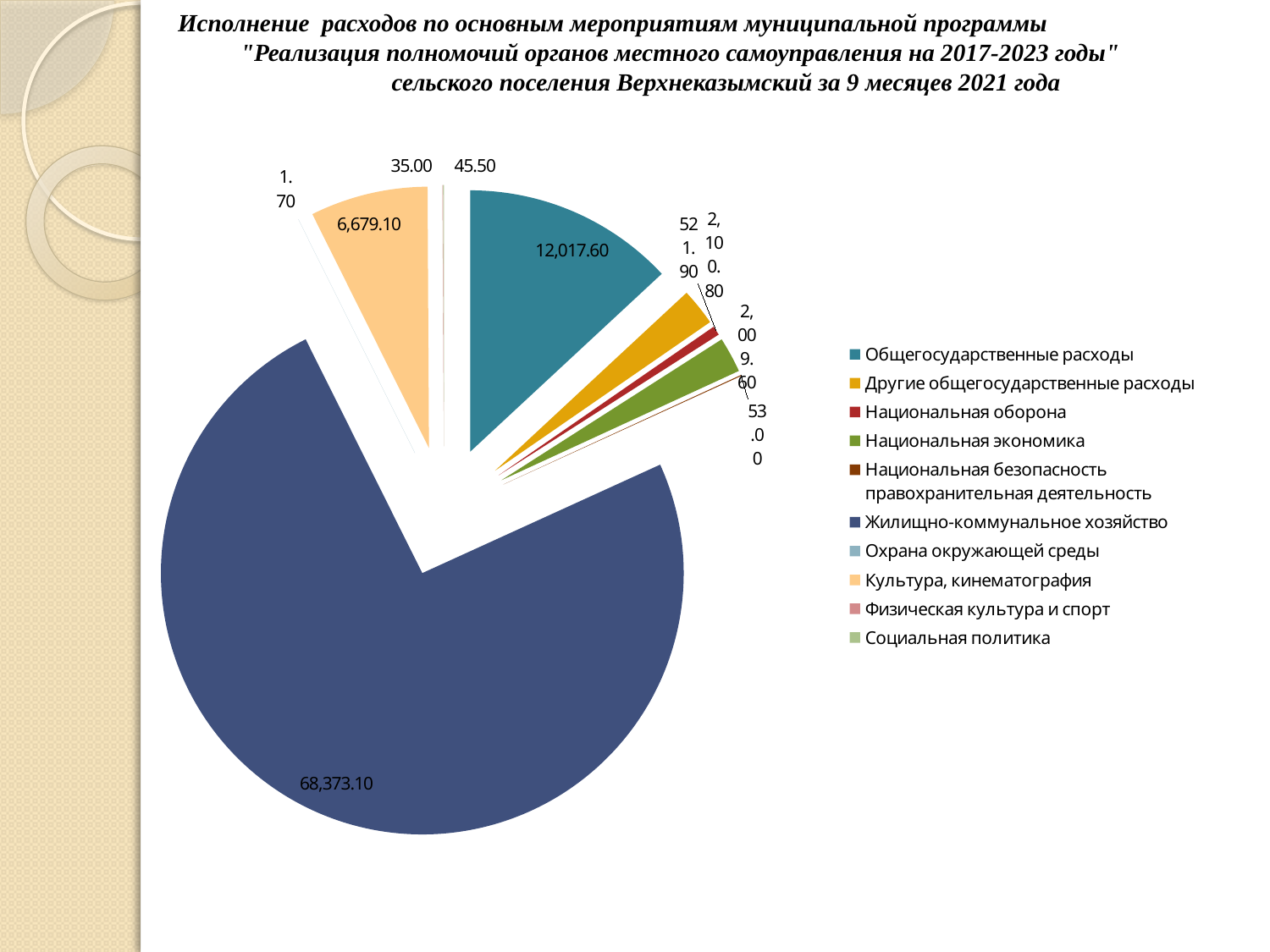
What colour is the slice for Жилищно-коммунальное хозяйство in the pie chart? dark blue Which category has the largest slice in the pie chart? Жилищно-коммунальное хозяйство What is the value shown for Общегосударственные расходы? 12,017.60 Which is larger, the value for Общегосударственные расходы or the value for Культура, кинематография? Общегосударственные расходы Which legend entry is listed first in the pie chart's legend? Общегосударственные расходы What is the difference between the values for Жилищно-коммунальное хозяйство and Общегосударственные расходы? 56,355.50 What is the value shown for Культура, кинематография? 6,679.10 How many categories does the legend of the pie chart list? 10 What kind of chart is shown on the slide? pie chart What is the difference between the values for Общегосударственные расходы and Культура, кинематография? 5,338.50 What is the value shown for Жилищно-коммунальное хозяйство? 68,373.10 Which is larger, the value for Жилищно-коммунальное хозяйство or the value for Культура, кинематография? Жилищно-коммунальное хозяйство